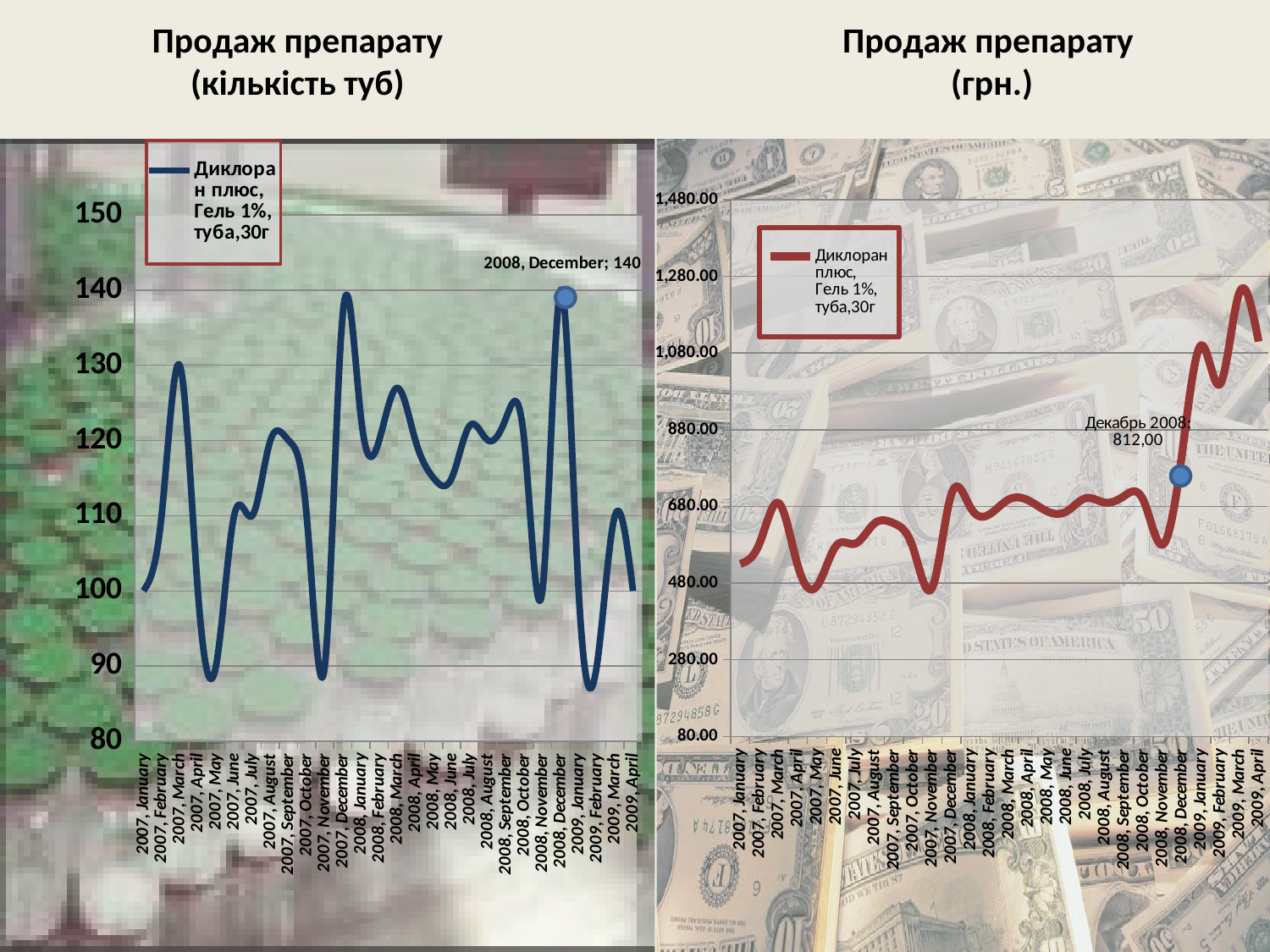
On the right chart (Продаж препарату (грн.)), what is the value for December 2008? 812,00 On the left chart (кількість туб), is the value for 2007, April greater or less than 120? less What type of chart is the right chart (Продаж препарату (грн.))? Line chart On the right chart (грн.), is the value for 2009, March greater or less than 1,280.00? less On the left chart (кількість туб), is the value for 2007, May greater or less than 100? less On the right chart (грн.), which month has the highest value? 2009, March On the left chart (Продаж препарату (кількість туб)), what is the value for 2008, December? 140 On the left chart (кількість туб), which is larger: the value for 2007, April or 2007, May? 2007, April How many months are plotted on the left chart (кількість туб)? 28 How many series does the legend of the right chart (грн.) list? 1 On the left chart (кількість туб), which month has the highest value? 2008, December